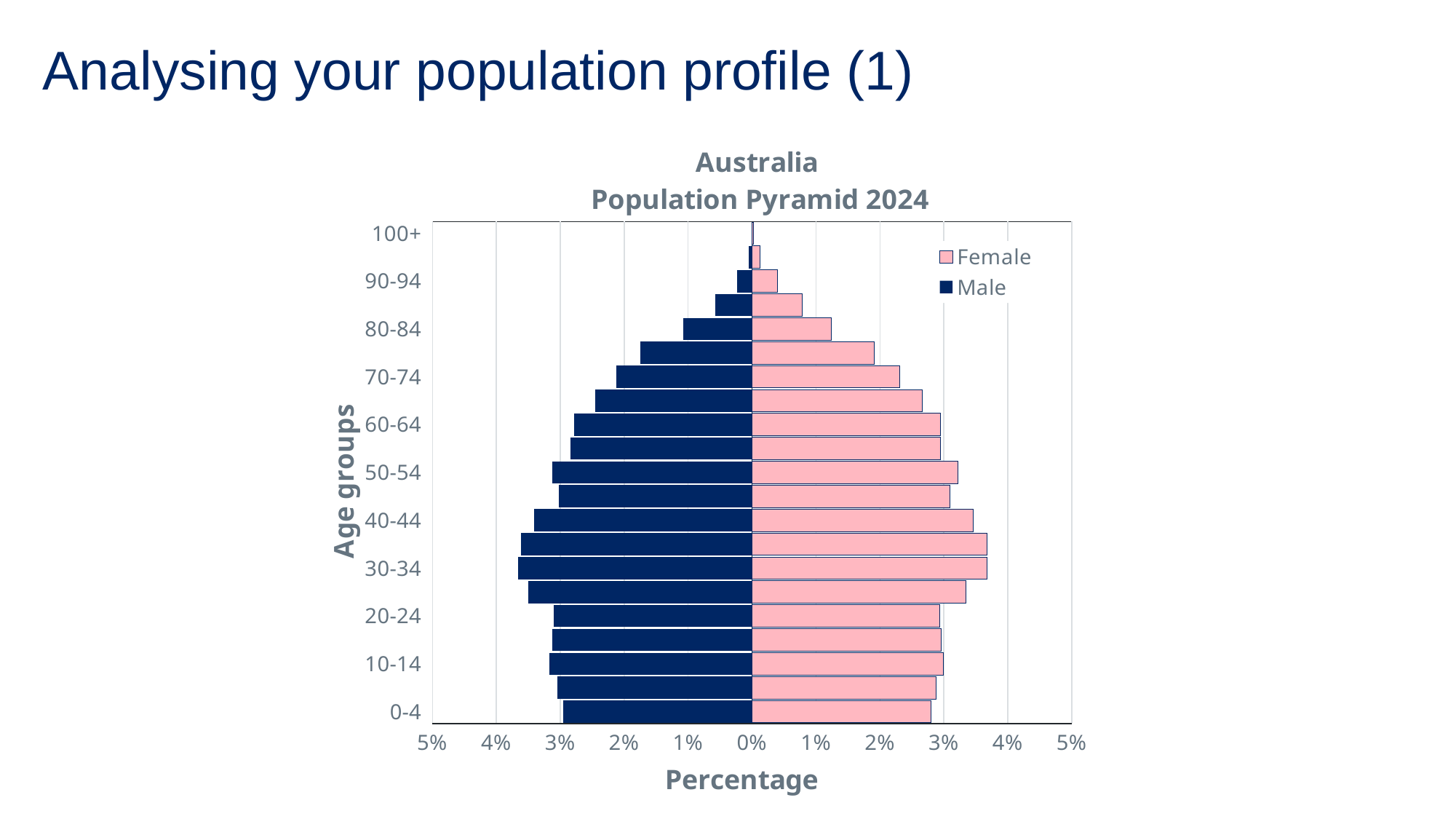
What is the title of the chart? Australia Population Pyramid 2024 What kind of chart is shown on the slide? bar chart For the 90-94 age group, which is larger, the Female value or the Male value? Female What are the two series named in the legend? Female and Male Is the Female value for the 80-84 age group greater or less than 2%? less Is the Male value for the 90-94 age group greater or less than 1%? less Is the Female value for the 40-44 age group greater or less than 3%? greater Which age group has the smallest Male value? 100+ How many series does the legend list? 2 How many age-group bars are plotted for each series? 21 Do the Male values rise or fall as the age groups go from 40-44 up to 100+? fall